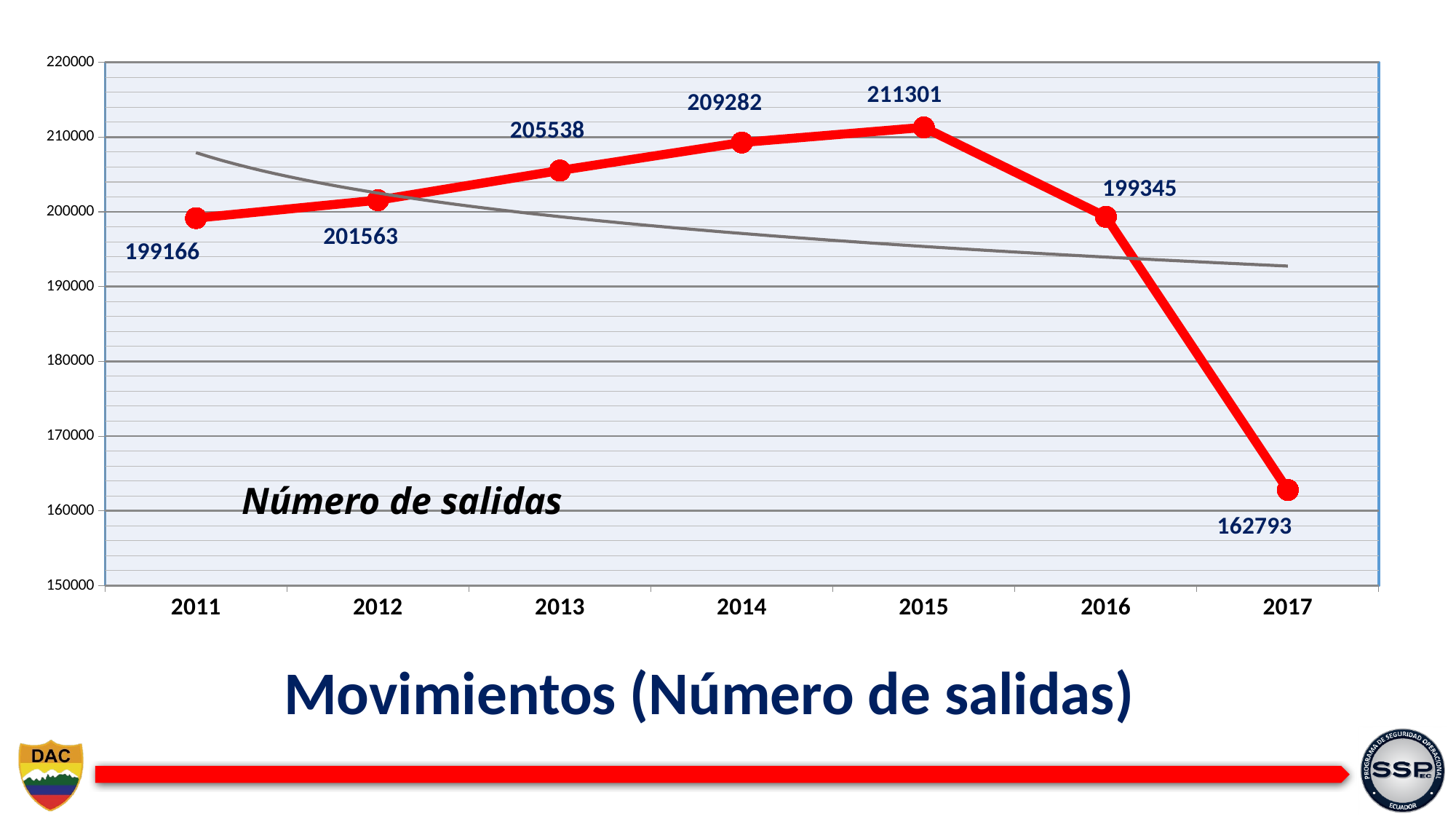
What kind of chart is shown on the slide? line chart What is the difference between the number of salidas in 2015 and 2017? 48508 Is the value for 2017 greater or less than 170000? less Which year has the lowest number of salidas? 2017 What is the number of salidas in 2015? 211301 What is the number of salidas in 2011? 199166 Which year has the highest number of salidas? 2015 Do the values rise or fall from 2015 to 2017? fall What is the number of salidas in 2017? 162793 What is the difference between the number of salidas in 2014 and 2013? 3744 How many years are plotted on the chart? 7 Which year has more salidas, 2012 or 2016? 2012